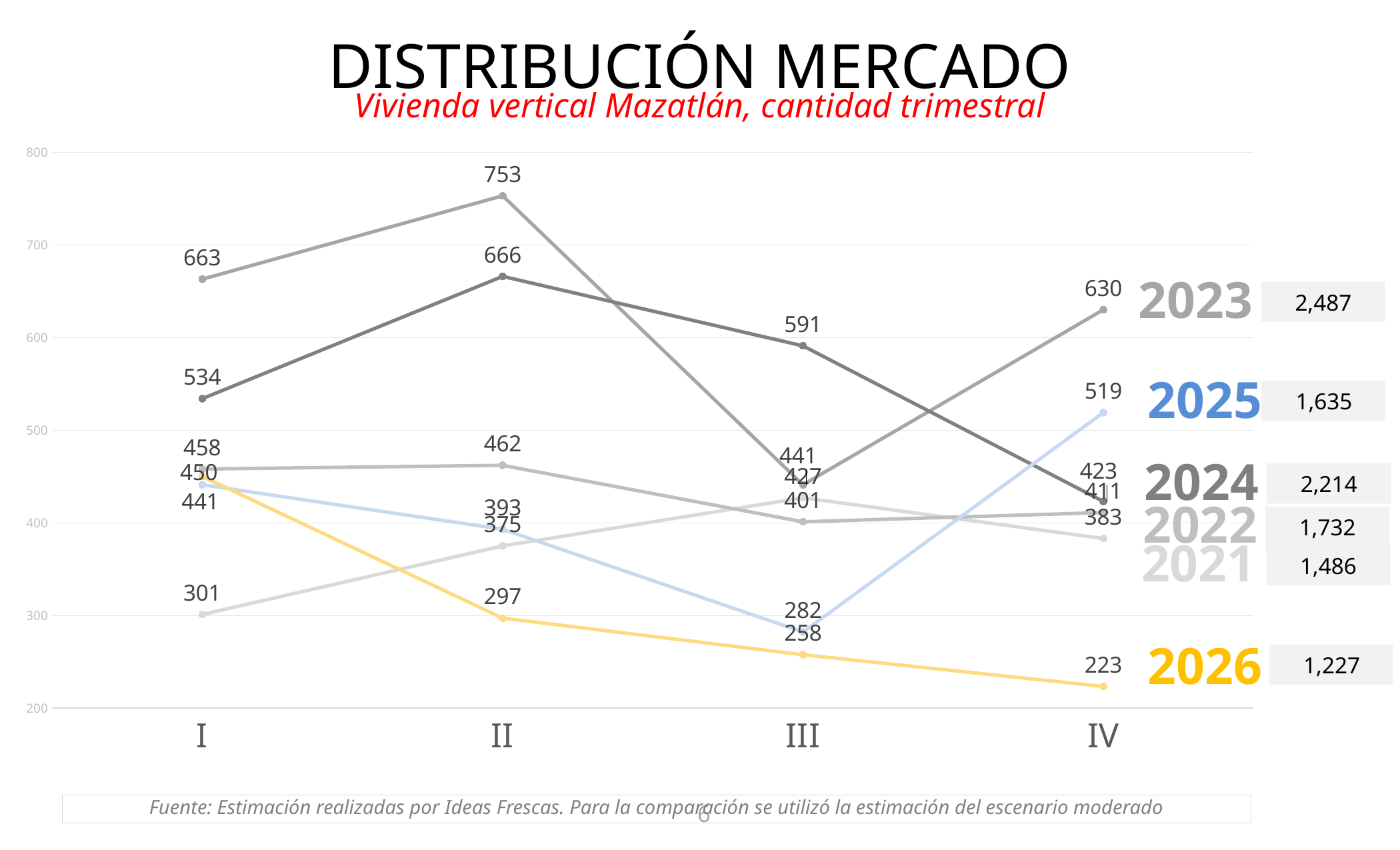
What is the lowest value plotted on the chart? 223 Does the 2026 (yellow) line rise or fall from quarter I to quarter IV? fall Which year has the larger annual total, 2024 or 2022? 2024 What is the value of the 2025 (blue) line in quarter IV? 519 How many quarters are shown on the x axis? 4 What annual total is shown next to the 2023 label? 2,487 What is the value of the 2025 (blue) line in quarter III? 282 What is the value of the 2026 (yellow) line in quarter IV? 223 What kind of chart is shown on the slide? line chart What is the highest value plotted on the chart, and in which quarter does it occur? 753, quarter II What is the difference between the 2025 line's quarter IV value (519) and its quarter III value (282)? 237 How many years (series) are listed on the right side of the chart? 6